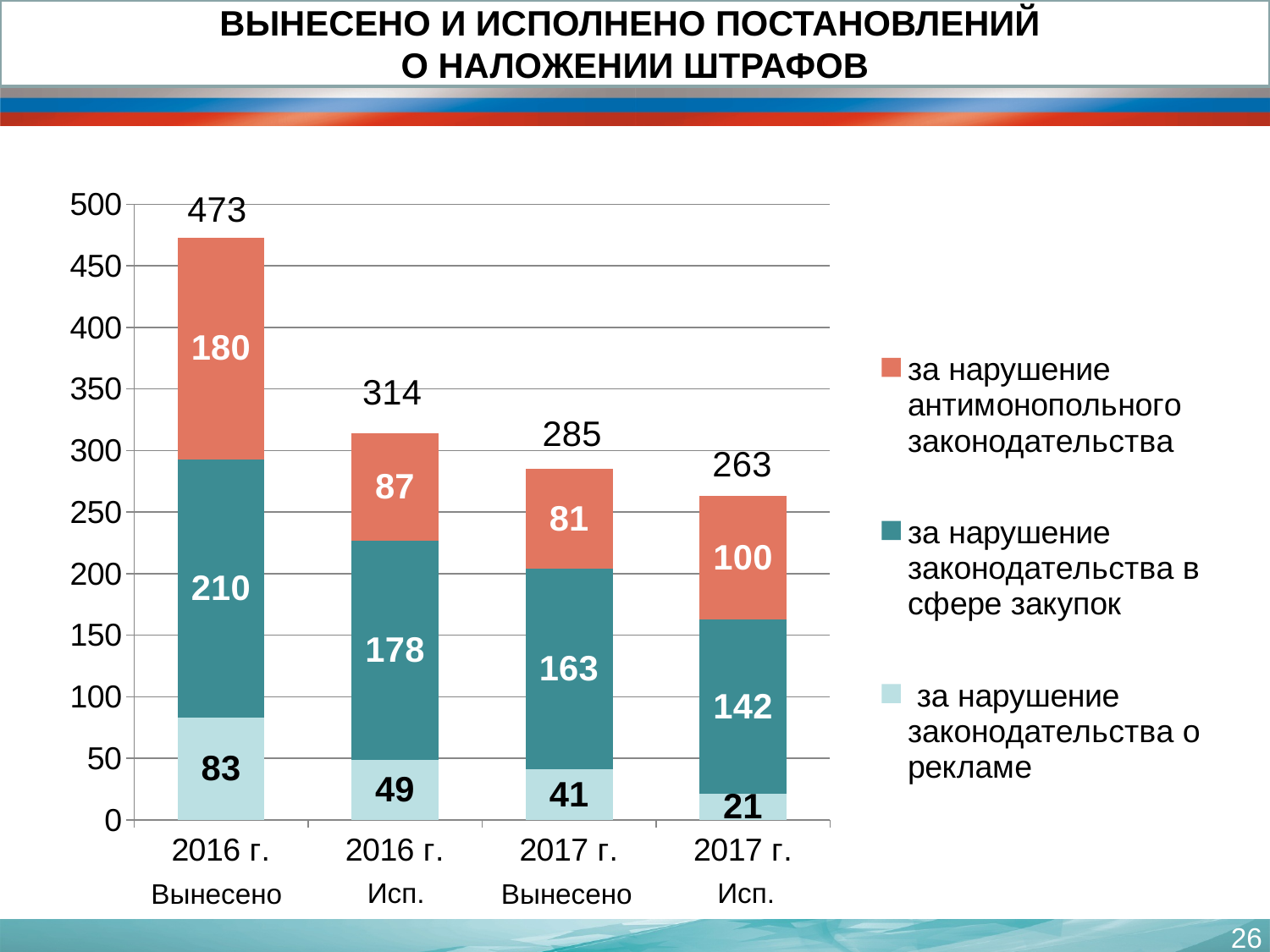
How many bars (categories) are shown on the x axis? 4 What is the value for 'за нарушение законодательства о рекламе' in '2017 г. Исп.'? 21 Which is larger: the 'за нарушение антимонопольного законодательства' value in '2017 г. Исп.' or in '2017 г. Вынесено'? 2017 г. Исп. Which bar has the lowest total? 2017 г. Исп. What is the difference between the totals for '2016 г. Вынесено' and '2017 г. Вынесено'? 188 What is the value for 'за нарушение законодательства в сфере закупок' in '2017 г. Вынесено'? 163 Which bar has the highest total? 2016 г. Вынесено What is the total for the bar '2016 г. Вынесено'? 473 What is the value for 'за нарушение антимонопольного законодательства' in '2016 г. Исп.'? 87 What type of chart is shown on the slide? Stacked bar chart How many series does the legend list? 3 Do the bar totals rise or fall from left to right along the x axis? Fall